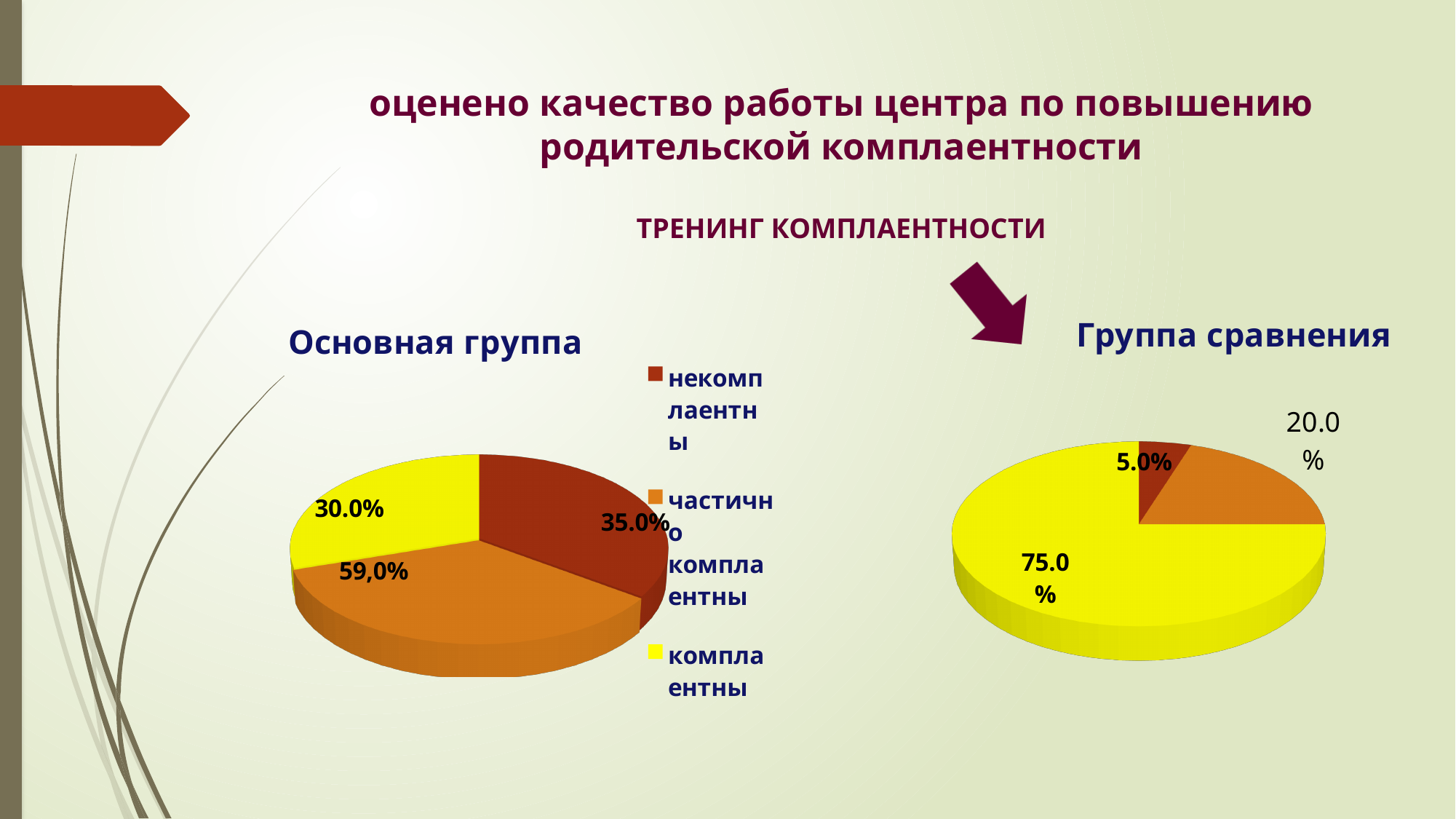
What kind of chart is the "Основная группа" chart? pie chart In the "Основная группа" chart, what label is printed on the orange "частично комплаентны" slice? 59,0% In the "Группа сравнения" chart, what is the difference between the "комплаентны" and "частично комплаентны" shares? 55.0% How many entries does the legend next to the "Основная группа" chart list? 3 In the "Группа сравнения" chart, which category has the smallest slice? некомплаентны In the "Группа сравнения" chart, what percentage is shown for "некомплаентны"? 5.0% In the "Группа сравнения" chart, what percentage is shown for "частично комплаентны"? 20.0% In the "Основная группа" chart, what percentage is shown for "комплаентны"? 30.0% In the "Группа сравнения" chart, which category has the largest slice? комплаентны In the "Основная группа" chart, what percentage is shown for "некомплаентны"? 35.0% In the "Группа сравнения" chart, what percentage is shown for "комплаентны"? 75.0% How many slices does the "Группа сравнения" pie chart have? 3